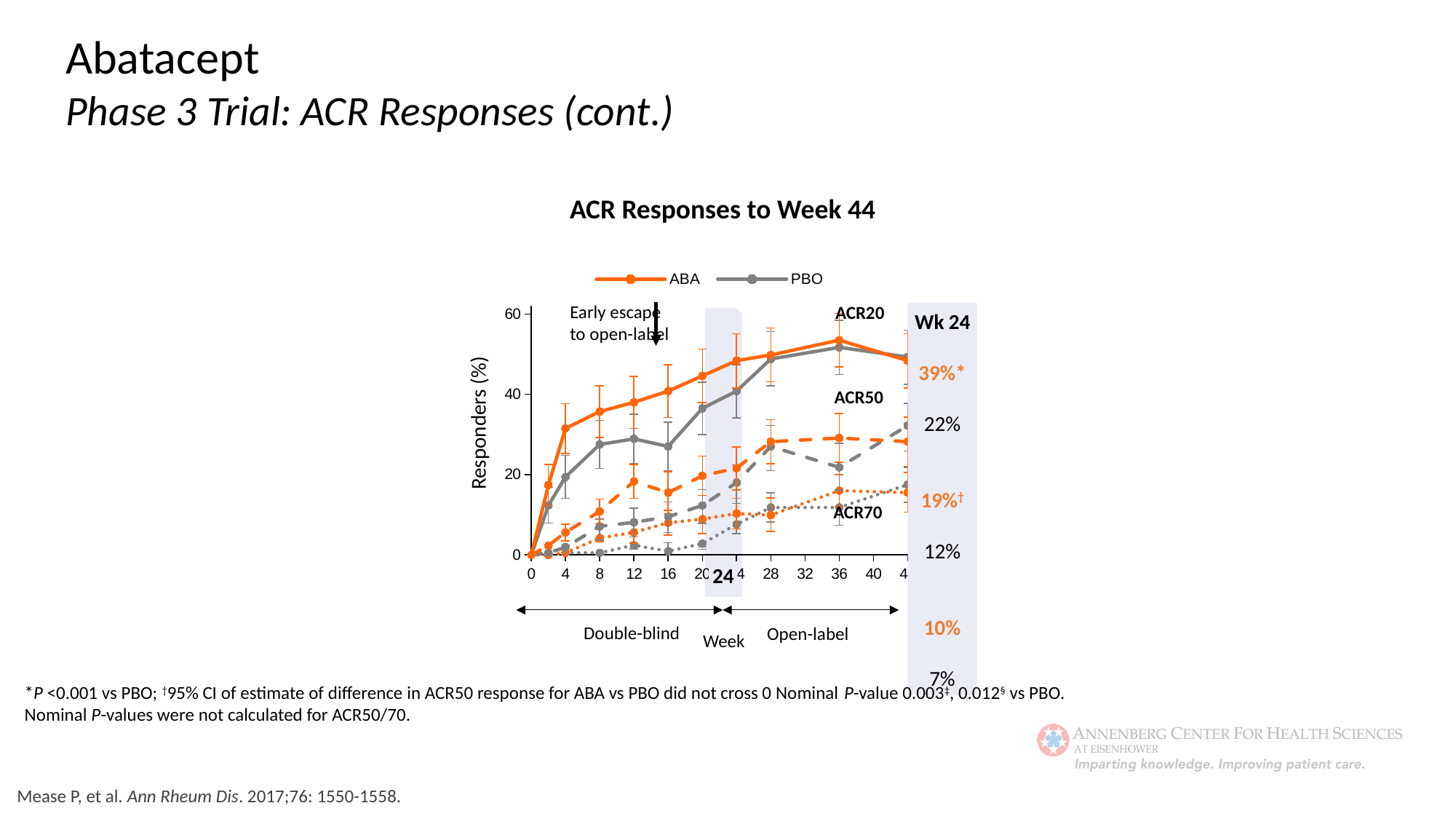
What is the label of the y axis? Responders (%) What is the ACR20 response rate for ABA at Week 24 as printed in the Wk 24 column? 39% What is the difference between the ABA and PBO ACR20 response rates at Week 24 as printed in the Wk 24 column? 17% Is the PBO ACR70 response at week 8 greater or less than 20? less How many series does the chart legend list? 2 What is the title of the chart? ACR Responses to Week 44 At Week 24, which group has the higher ACR50 response rate, ABA or PBO? ABA What is the ACR20 response rate for PBO at Week 24 as printed in the Wk 24 column? 22% What kind of chart is shown on the slide? line chart What is the ACR70 response rate for PBO at Week 24 as printed in the Wk 24 column? 7% Is the ABA ACR20 response at week 36 greater or less than 40? greater What is the ACR50 response rate for ABA at Week 24 as printed in the Wk 24 column? 19%